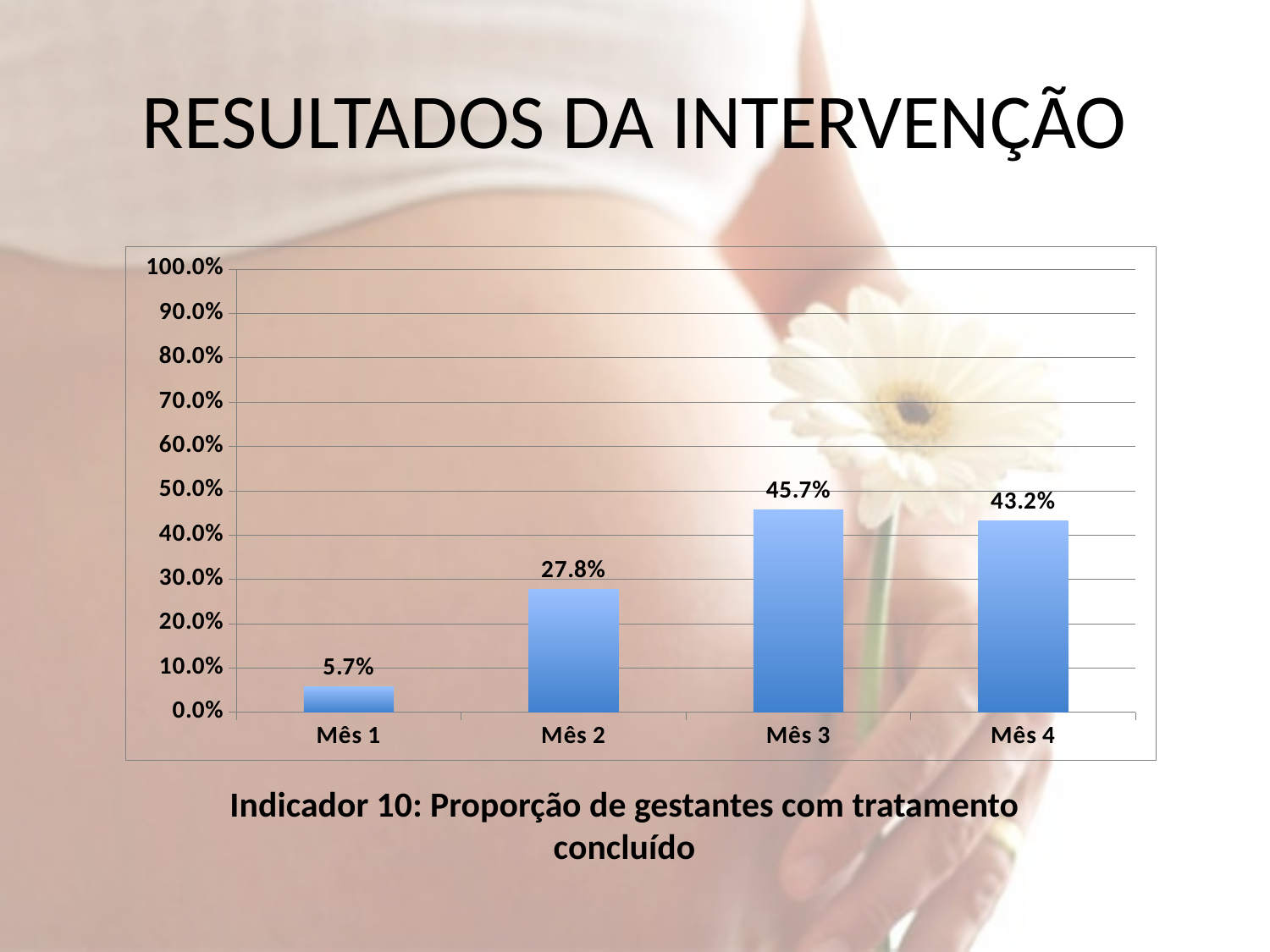
What kind of chart is shown on the slide? bar chart What is the difference between the values for Mês 2 and Mês 1? 22.1% How many months are shown on the x axis? 4 What is the value for Mês 3? 45.7% What is the value for Mês 4? 43.2% What is the difference between the values for Mês 3 and Mês 4? 2.5% What is the value for Mês 1? 5.7% Which is larger, the value for Mês 2 or the value for Mês 4? Mês 4 Is the value for Mês 3 greater or less than 50.0%? less Which month has the lowest value? Mês 1 What is the caption below the chart? Indicador 10: Proporção de gestantes com tratamento concluído Which month has the highest value? Mês 3